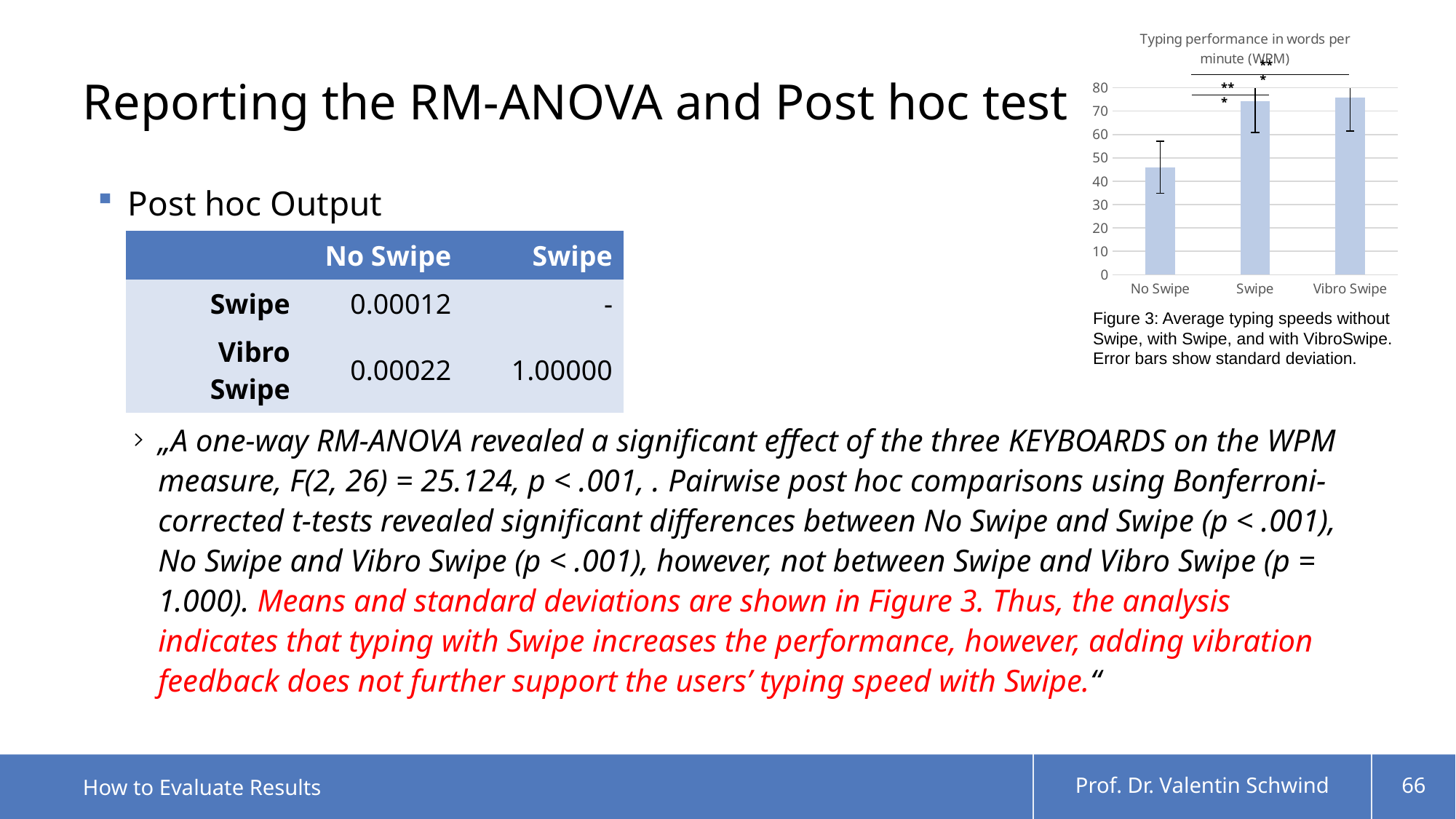
Which is larger, the value for No Swipe or the value for Swipe? Swipe Is the value for No Swipe greater or less than 40? greater Which category has the lowest typing performance in the chart? No Swipe What is the title of the chart? Typing performance in words per minute (WPM) Is the value for Swipe greater or less than 70? greater What is the highest tick value shown on the chart's y axis? 80 What kind of chart is shown on the slide? bar chart Is the value for Vibro Swipe greater or less than 70? greater Which is larger, the value for No Swipe or the value for Vibro Swipe? Vibro Swipe How many categories are shown on the x axis of the chart? 3